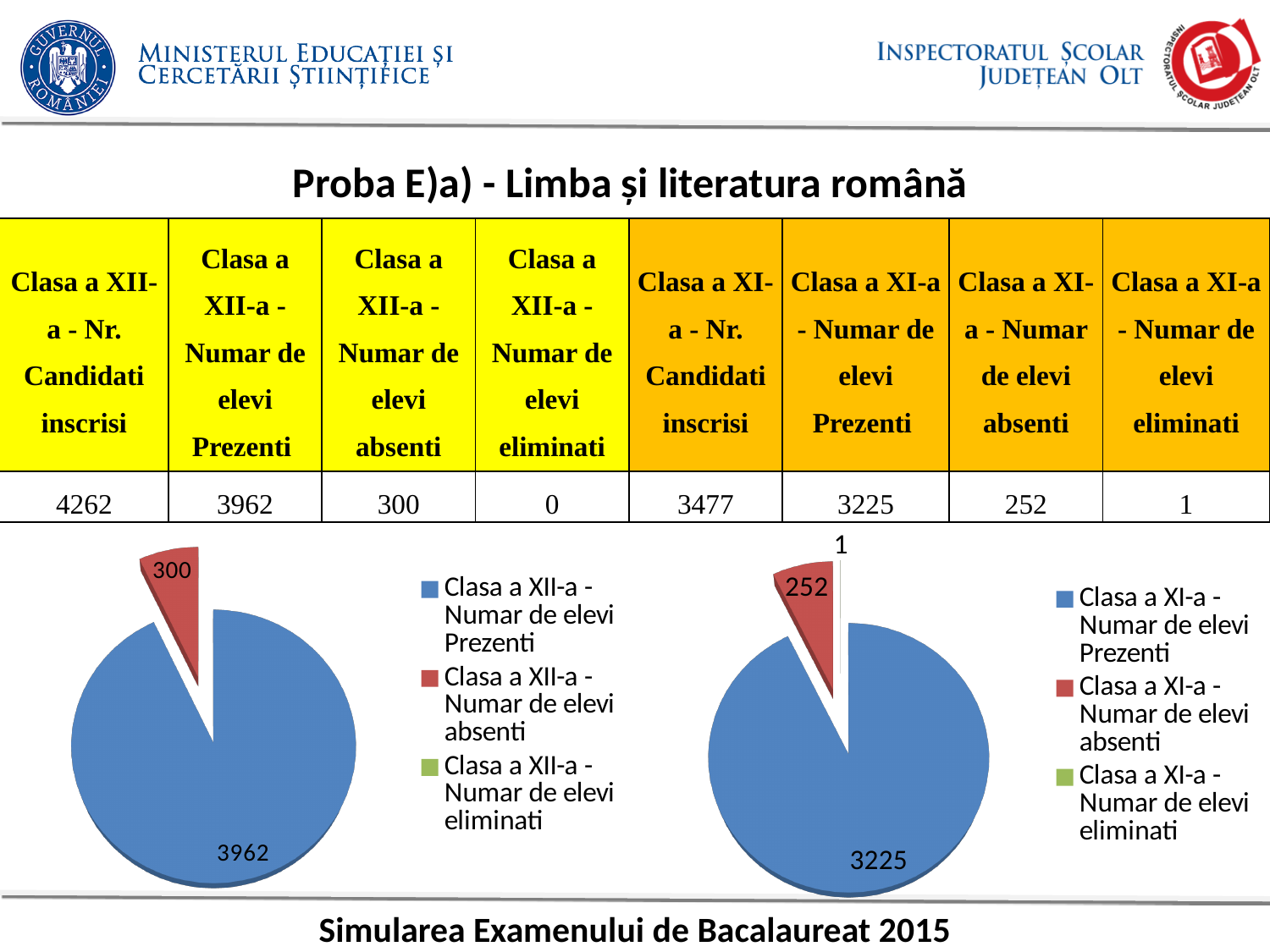
In the left pie chart (Clasa a XII-a), what is the value for Numar de elevi Prezenti? 3962 In the right pie chart (Clasa a XI-a), what is the value for Numar de elevi eliminati? 1 What type of chart is shown on the left side of the slide? pie chart Which is larger: Numar de elevi absenti in the left pie chart (Clasa a XII-a) or Numar de elevi absenti in the right pie chart (Clasa a XI-a)? Clasa a XII-a (300) In the right pie chart (Clasa a XI-a), which category has the smallest value? Clasa a XI-a - Numar de elevi eliminati In the right pie chart (Clasa a XI-a), what is the value for Numar de elevi Prezenti? 3225 In the left pie chart (Clasa a XII-a), what is the difference between Numar de elevi Prezenti and Numar de elevi absenti? 3662 In the right pie chart (Clasa a XI-a), what is the difference between Numar de elevi absenti and Numar de elevi eliminati? 251 In the left pie chart (Clasa a XII-a), what is the value for Numar de elevi absenti? 300 In the right pie chart (Clasa a XI-a), what is the value for Numar de elevi absenti? 252 How many entries does the legend of the right pie chart (Clasa a XI-a) list? 3 In the left pie chart (Clasa a XII-a), which category has the largest slice? Clasa a XII-a - Numar de elevi Prezenti